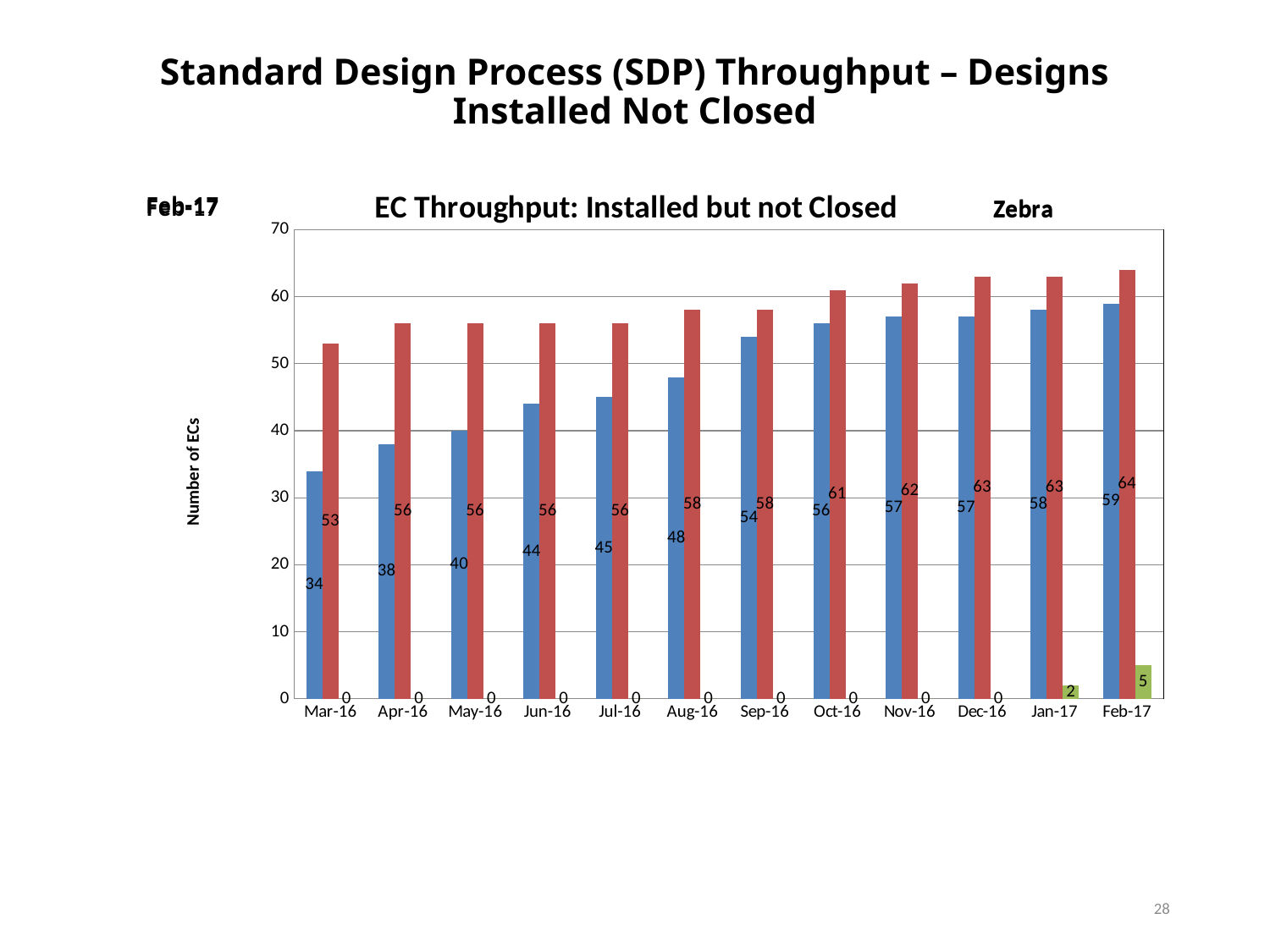
What is the difference between the red bar and the blue bar for Mar-16? 19 What kind of chart is shown? bar chart Is the value of the blue bar for Jun-16 greater or less than 40? greater What is the value of the red bar for Feb-17? 64 What is the value of the blue bar for Mar-16? 34 How many months are shown on the x axis? 12 Do the blue bars rise or fall from Mar-16 to Feb-17? rise Which is larger for Sep-16, the blue bar or the red bar? the red bar What is the value of the green bar for Jan-17? 2 What is the label on the y axis? Number of ECs Which month has the lowest red bar? Mar-16 Which month has the highest blue bar? Feb-17